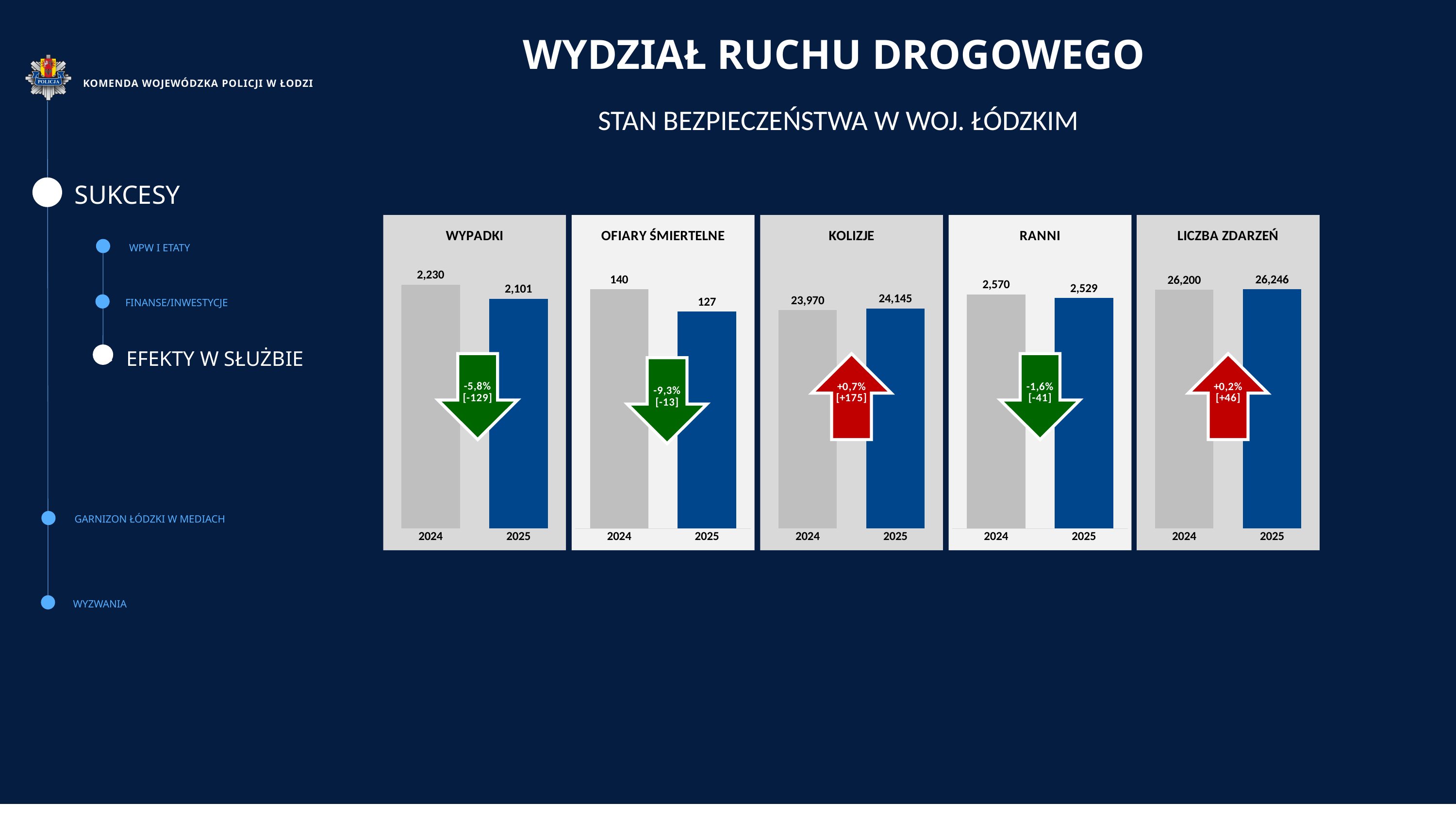
In the WYPADKI chart, do the values rise or fall from 2024 to 2025? fall In the WYPADKI chart, what is the value for 2025? 2,101 In the OFIARY ŚMIERTELNE chart, what is the difference between the 2024 and 2025 values? 13 In the RANNI chart, which year has the lower value? 2025 In the KOLIZJE chart, which year has the higher value, 2024 or 2025? 2025 What kind of chart is the LICZBA ZDARZEŃ chart? bar chart In the RANNI chart, what is the value for 2025? 2,529 How many bars does the RANNI chart show? 2 In the OFIARY ŚMIERTELNE chart, what is the value for 2025? 127 In the KOLIZJE chart, what is the value for 2024? 23,970 In the LICZBA ZDARZEŃ chart, what is the value for 2025? 26,246 In the WYPADKI chart, what is the value for 2024? 2,230